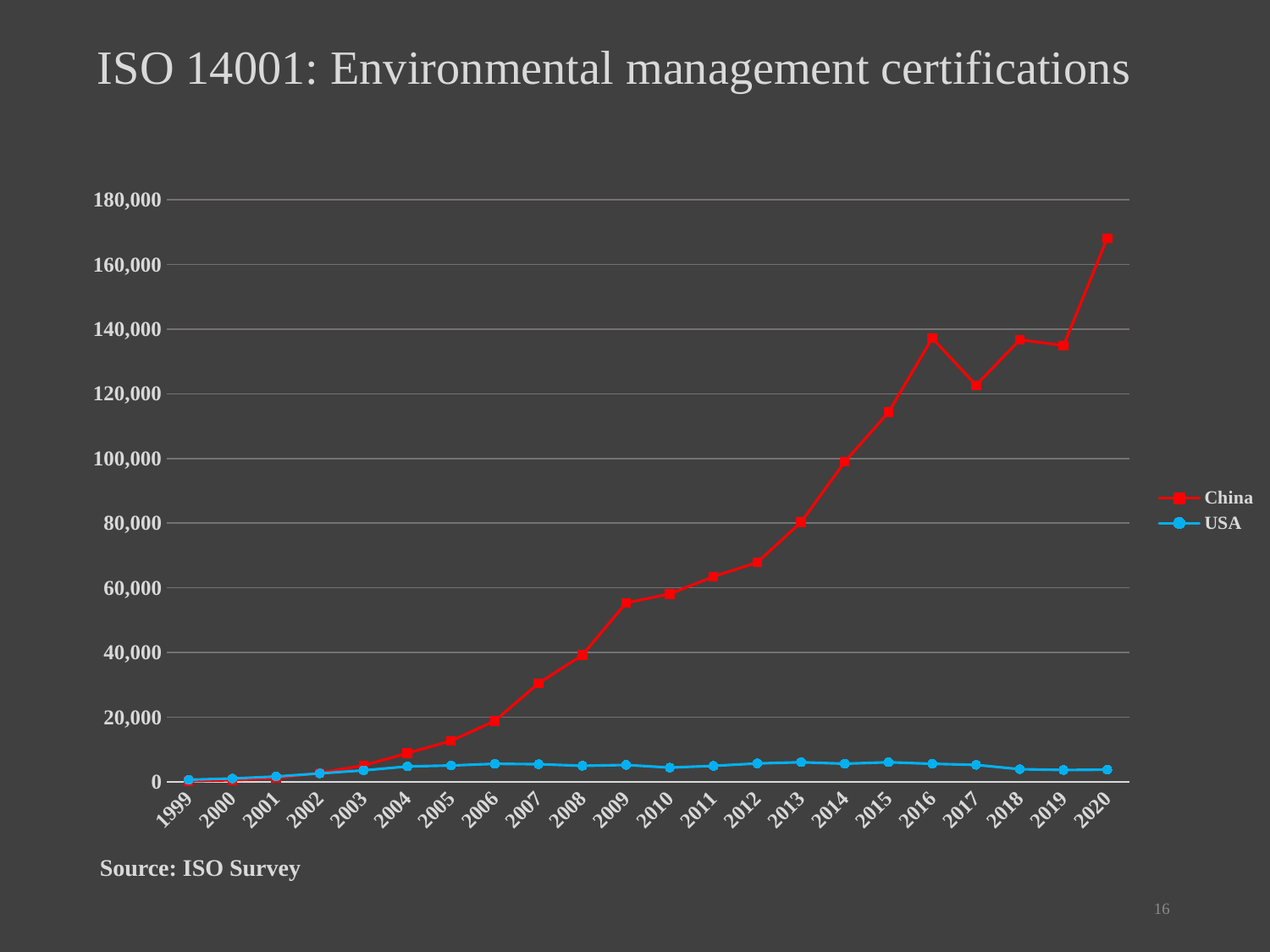
What colour is the line for the USA series? blue Is the value for China in 2020 greater or less than 160,000? greater In which year is the China series at its lowest value? 1999 How many years are plotted along the x axis? 22 Is the value for China in 2017 greater or less than 140,000? less Is the value for USA in 2020 greater or less than 20,000? less What kind of chart is shown on the slide? line chart Overall, does the China series rise or fall from 1999 to 2020? rise In which year does the China series reach its highest value? 2020 How many series does the legend list? 2 In 2020, which series has the larger value, China or USA? China